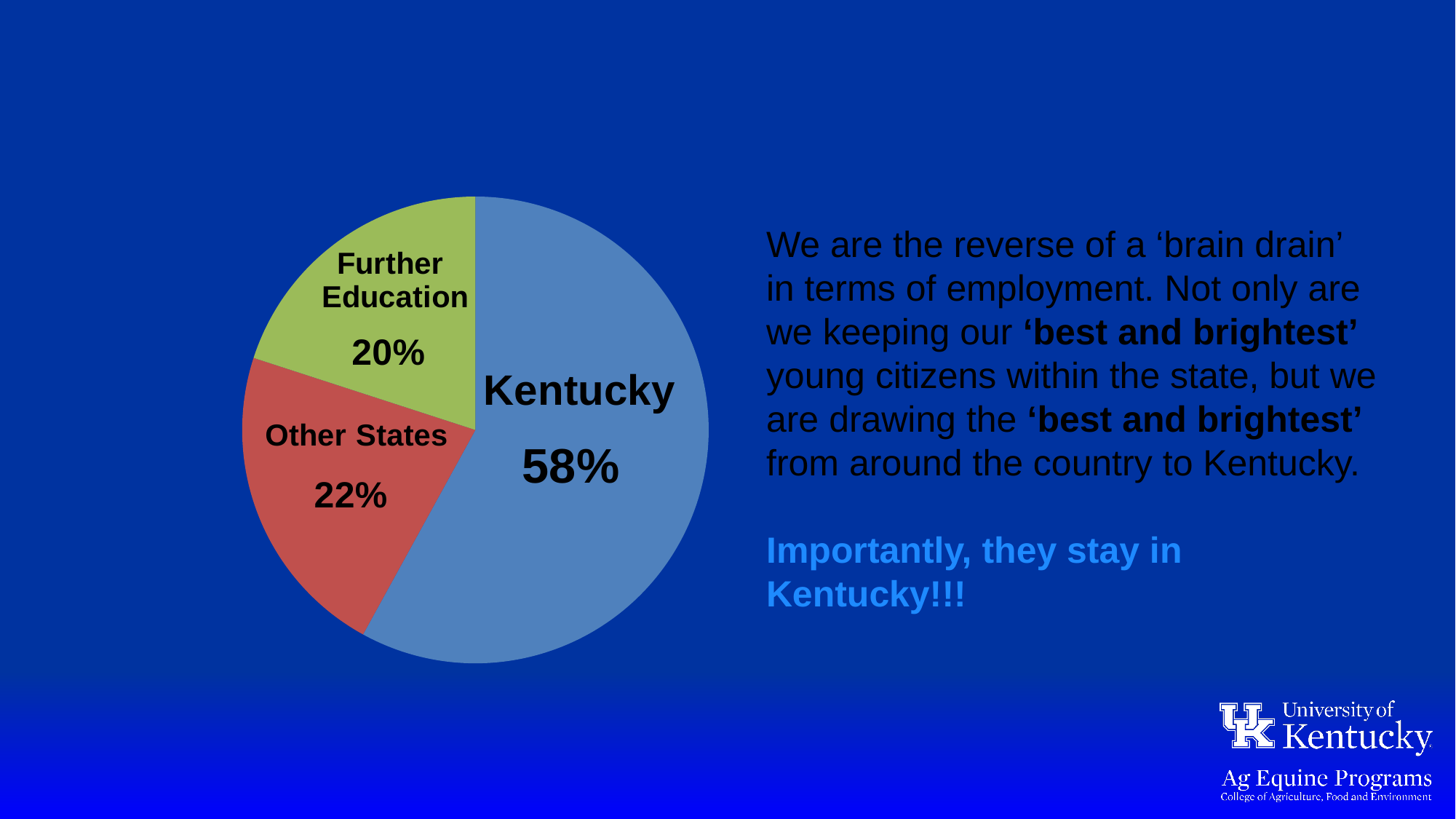
How many slices does the pie chart have? 3 What percentage of the pie is labelled Further Education? 20% What percentage of the pie is labelled Other States? 22% Which slice of the pie is the largest? Kentucky What colour is the Other States slice of the pie? red What percentage of the pie is labelled Kentucky? 58% What colour is the Kentucky slice of the pie? blue Which slice of the pie is the smallest? Further Education Which is larger, the Kentucky slice or the Further Education slice? Kentucky What is the difference in percentage points between the Other States slice and the Further Education slice? 2 What kind of chart is shown on the slide? pie chart What is the difference in percentage points between the Kentucky slice and the Other States slice? 36